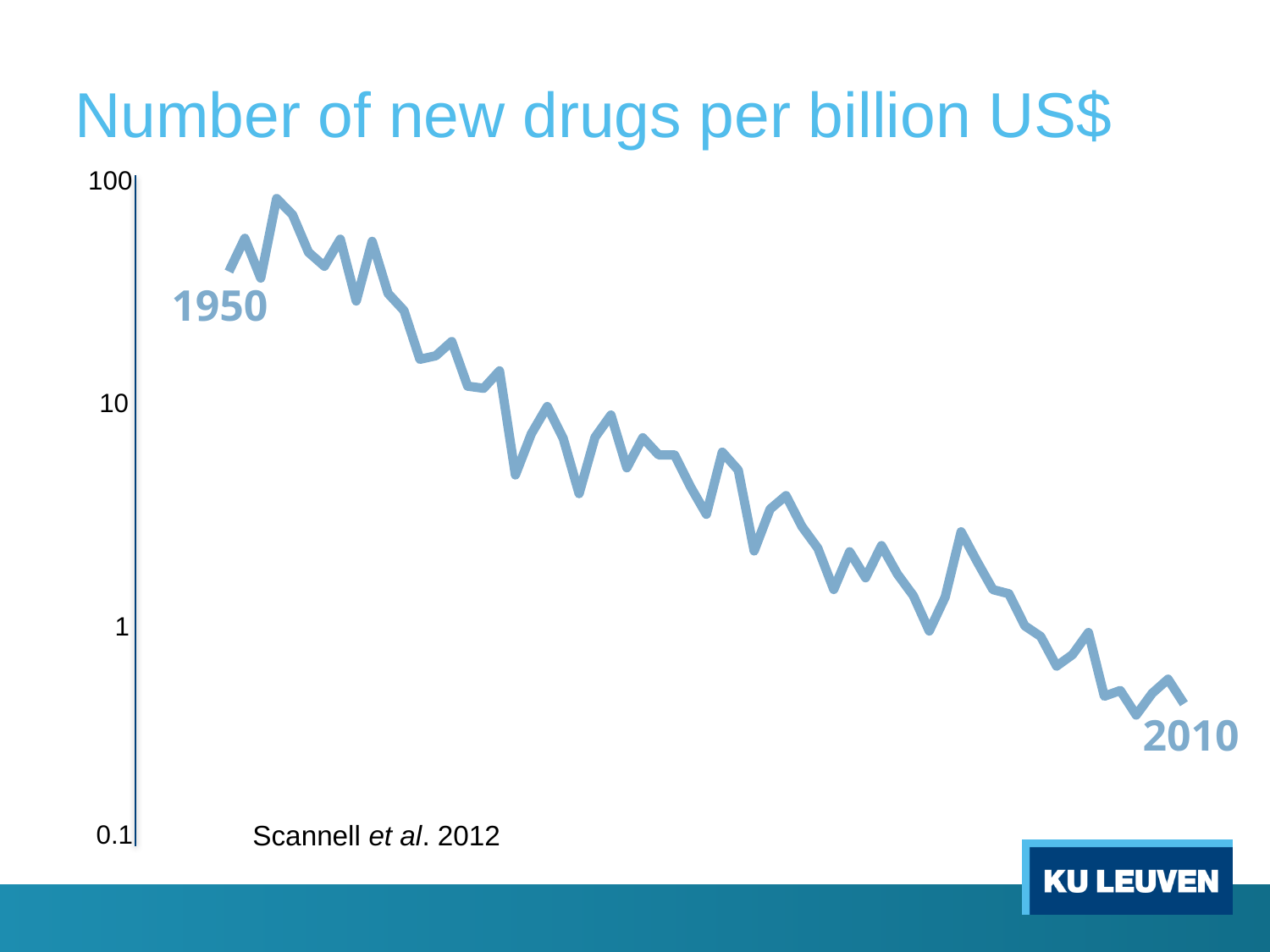
What is the highest tick value shown on the y axis? 100 What is the lowest tick value shown on the y axis? 0.1 Is the value for 1950 greater or less than 10? greater Is the value for 2010 greater or less than 0.1? greater Which year has the larger value, 1950 or 2010? 1950 What kind of chart is shown on the slide? line chart Is the value for 1950 greater or less than 100? less What is the title of the chart? Number of new drugs per billion US$ Do the values rise or fall from 1950 to 2010? fall